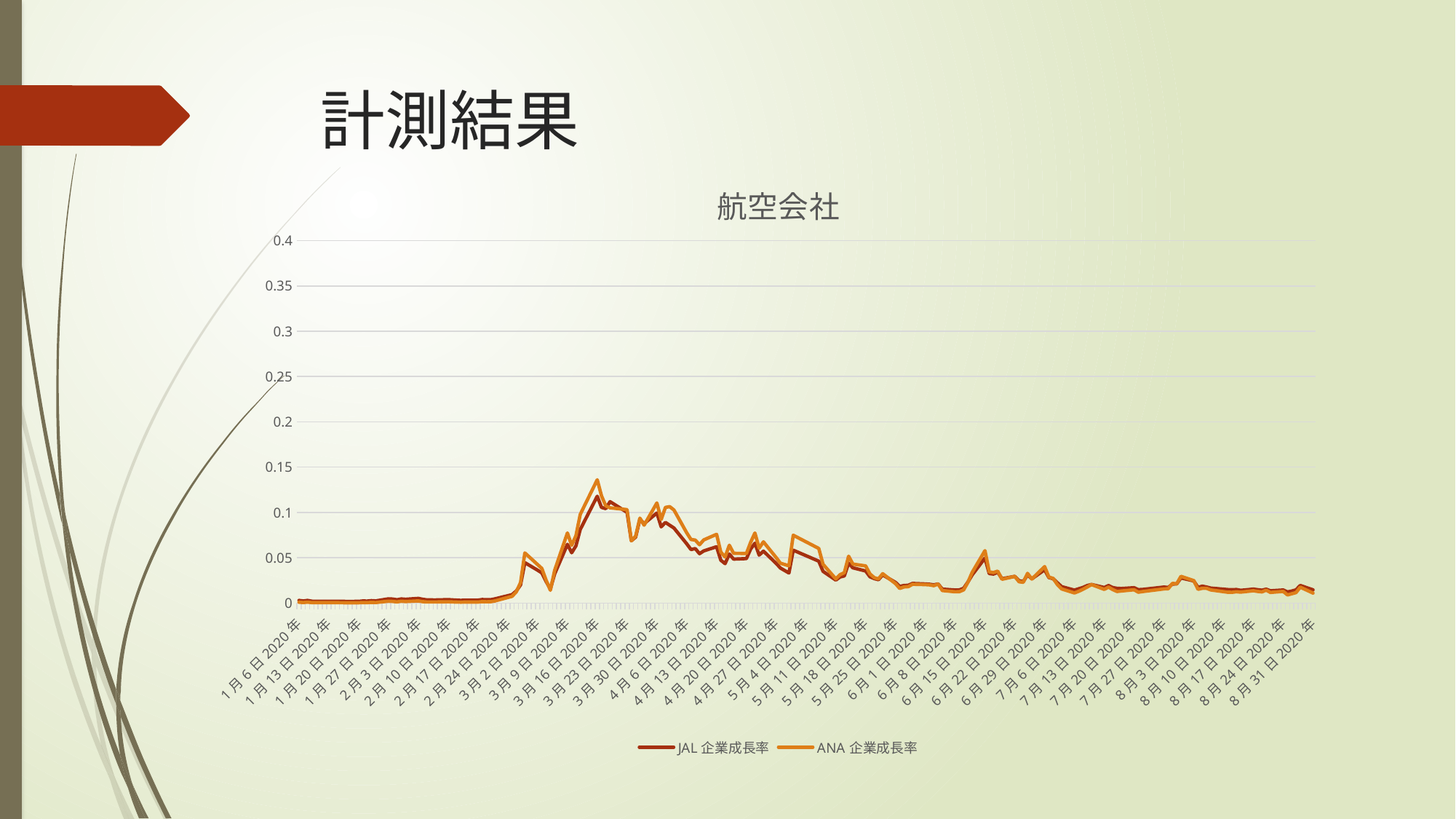
In which month do both series reach their highest values? 3月 (March) Do the values rise or fall overall from 3月23日 to 8月31日? fall Is the value of ANA 企業成長率 on 8月31日 2020年 greater or less than 0.05? less How many series does the legend of the 航空会社 chart list? 2 Do the values rise or fall from 2月24日 to 3月23日? rise Is the value of JAL 企業成長率 on 1月6日 2020年 greater or less than 0.05? less What kind of chart is shown on the slide? line chart Which two series are listed in the legend? JAL 企業成長率 and ANA 企業成長率 What is the title of the chart? 航空会社 Is the peak value of either series greater or less than 0.2? less Which series reaches the higher peak value in late March? ANA 企業成長率